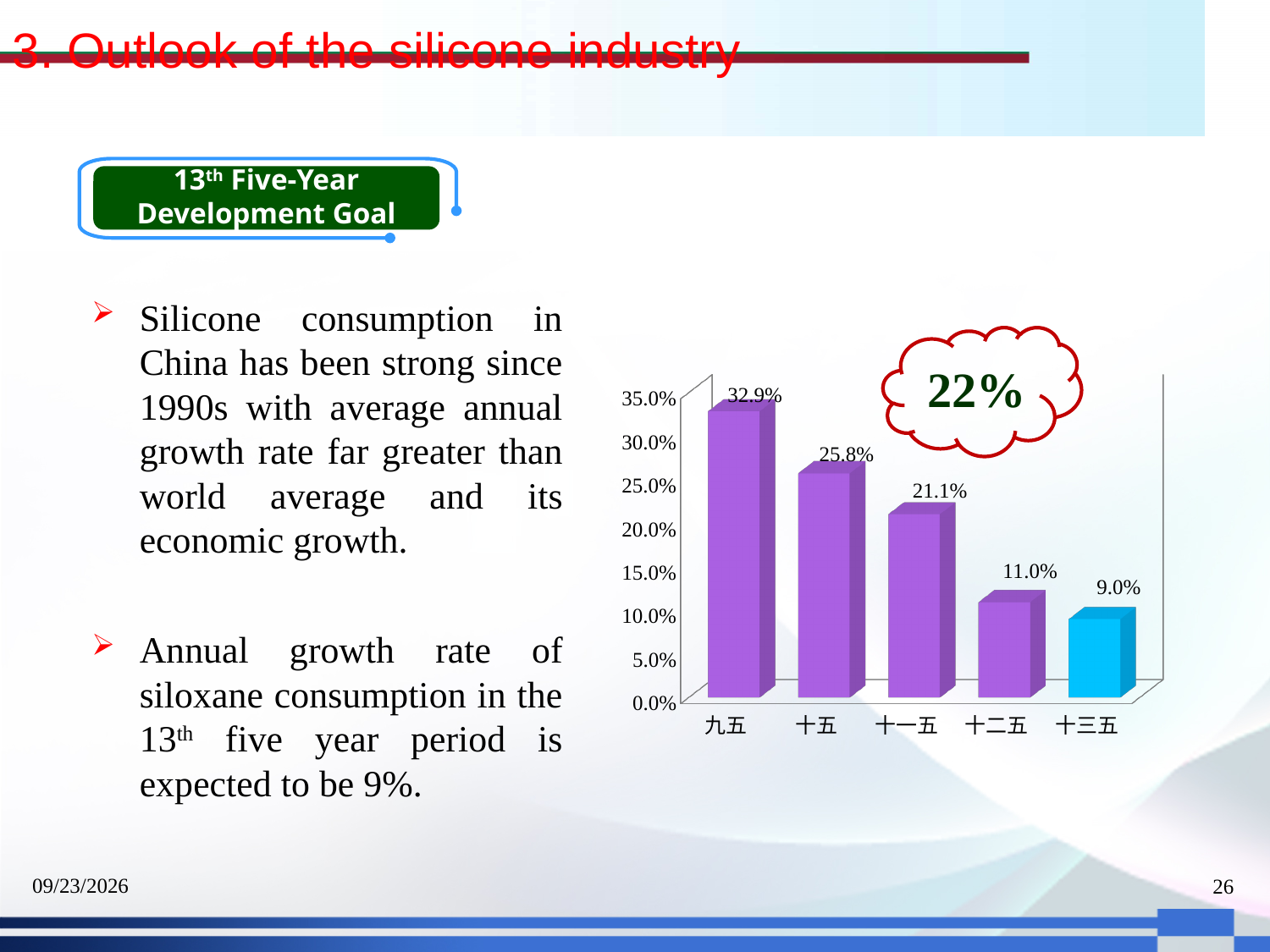
What is the difference between the values for 九五 and 十五? 7.1% What is the value for 十三五 in the bar chart? 9.0% What is the value for 九五 in the bar chart? 32.9% What kind of chart is shown on the slide? bar chart What is the value for 十一五 in the bar chart? 21.1% How many categories are shown on the x axis of the bar chart? 5 What is the value for 十二五 in the bar chart? 11.0% Which category has the lowest value in the bar chart? 十三五 Which is larger, the value for 十一五 or the value for 十二五? 十一五 Do the values rise or fall from left to right along the x axis? fall What is the value for 十五 in the bar chart? 25.8% Which category has the highest value in the bar chart? 九五